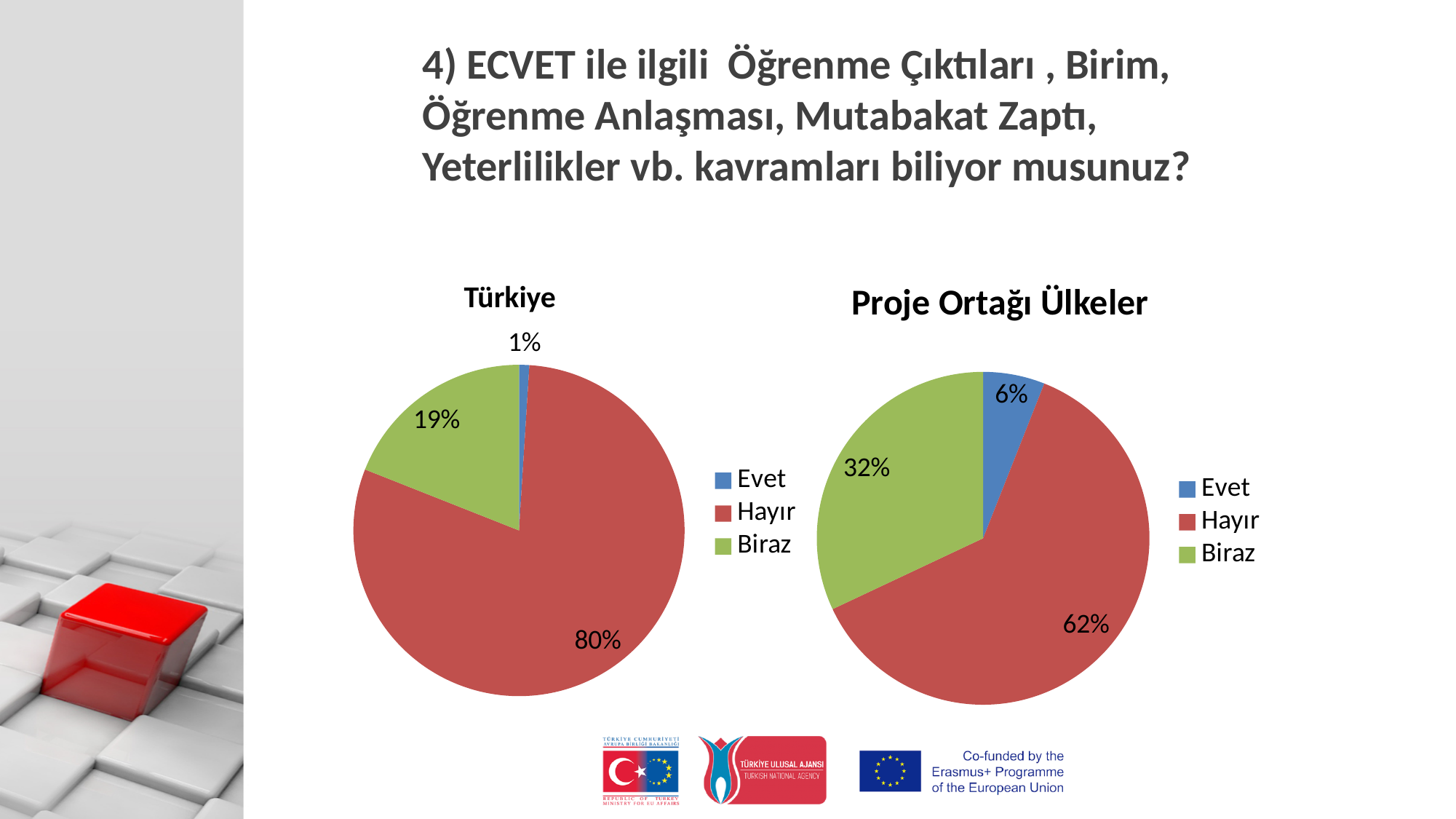
In the Proje Ortağı Ülkeler pie chart, what share of responses is Hayır? 62% How many categories does the legend of the Proje Ortağı Ülkeler chart list? 3 In the Proje Ortağı Ülkeler pie chart, which category has the smallest slice? Evet What type of chart is the Türkiye chart? Pie chart In the Proje Ortağı Ülkeler pie chart, what share of responses is Evet? 6% Which is larger: the Biraz share in the Türkiye chart or the Biraz share in the Proje Ortağı Ülkeler chart? Proje Ortağı Ülkeler In the Türkiye pie chart, which category has the largest slice? Hayır In the Türkiye pie chart, what share of responses is Hayır? 80% What is the difference between the Hayır share in the Türkiye chart and the Hayır share in the Proje Ortağı Ülkeler chart? 18%